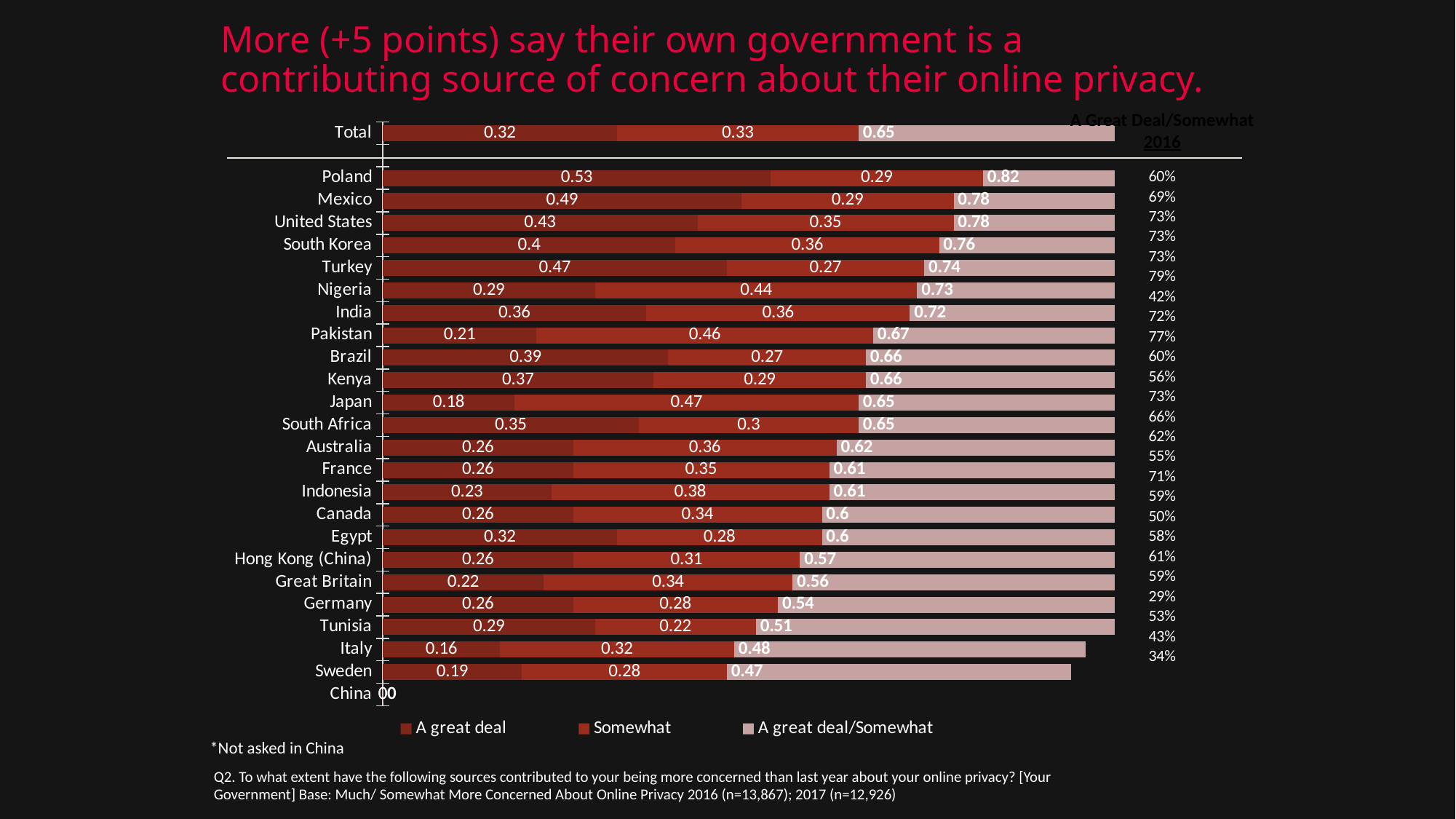
Which has the larger 'A great deal' value, Mexico or the United States? Mexico How many series does the legend list? 3 Which country has the lowest 'A great deal' value? Italy What is the 'A great deal' value for Poland? 0.53 What kind of chart is shown on the slide? Bar chart According to the footnote, which country was the question not asked in? China Which country has the highest 'A great deal/Somewhat' value? Poland What is the 'A great deal/Somewhat' value for the Total row? 0.65 What is the 'Somewhat' value for Japan? 0.47 What is the difference between the 'Somewhat' and 'A great deal' values for Nigeria? 0.15 What is the difference between the 'A great deal/Somewhat' values for Poland and Sweden? 0.35 How many countries are listed on the chart's axis (excluding Total)? 24